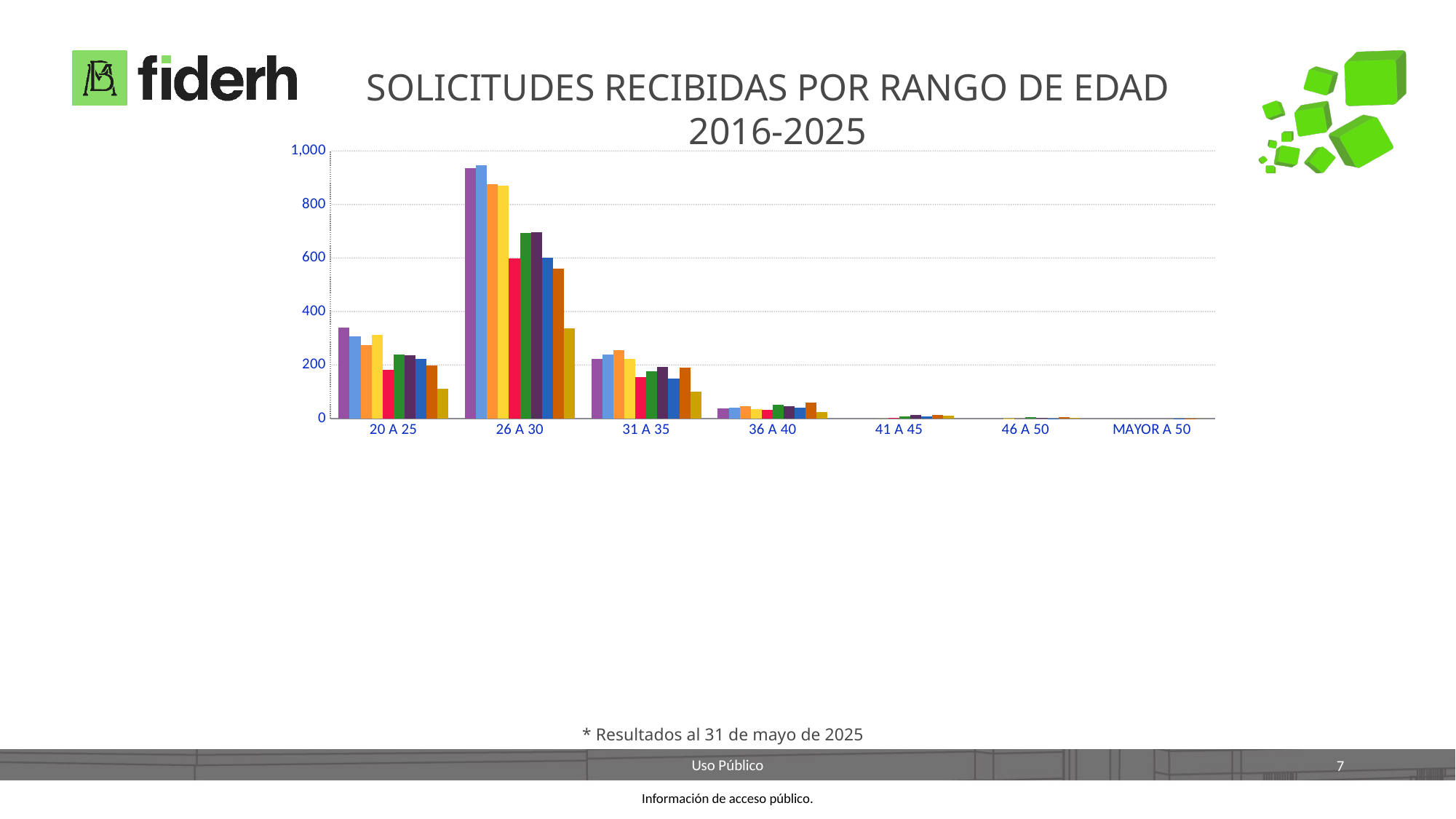
Is the tallest bar for 26 A 30 greater or less than 800? greater Moving from 26 A 30 to MAYOR A 50 along the x axis, do the values rise or fall? fall What kind of chart is shown on the slide? Bar chart What is the title of the chart? SOLICITUDES RECIBIDAS POR RANGO DE EDAD 2016-2025 Which age range has the lowest number of applications received? MAYOR A 50 Which age range has the highest number of applications received? 26 A 30 How many age range categories are shown on the x axis? 7 What is the highest tick value shown on the y axis? 1,000 Is the tallest bar for 31 A 35 greater or less than 400? less Is the tallest bar for 20 A 25 greater or less than 400? less Which age range has higher values, 26 A 30 or 31 A 35? 26 A 30